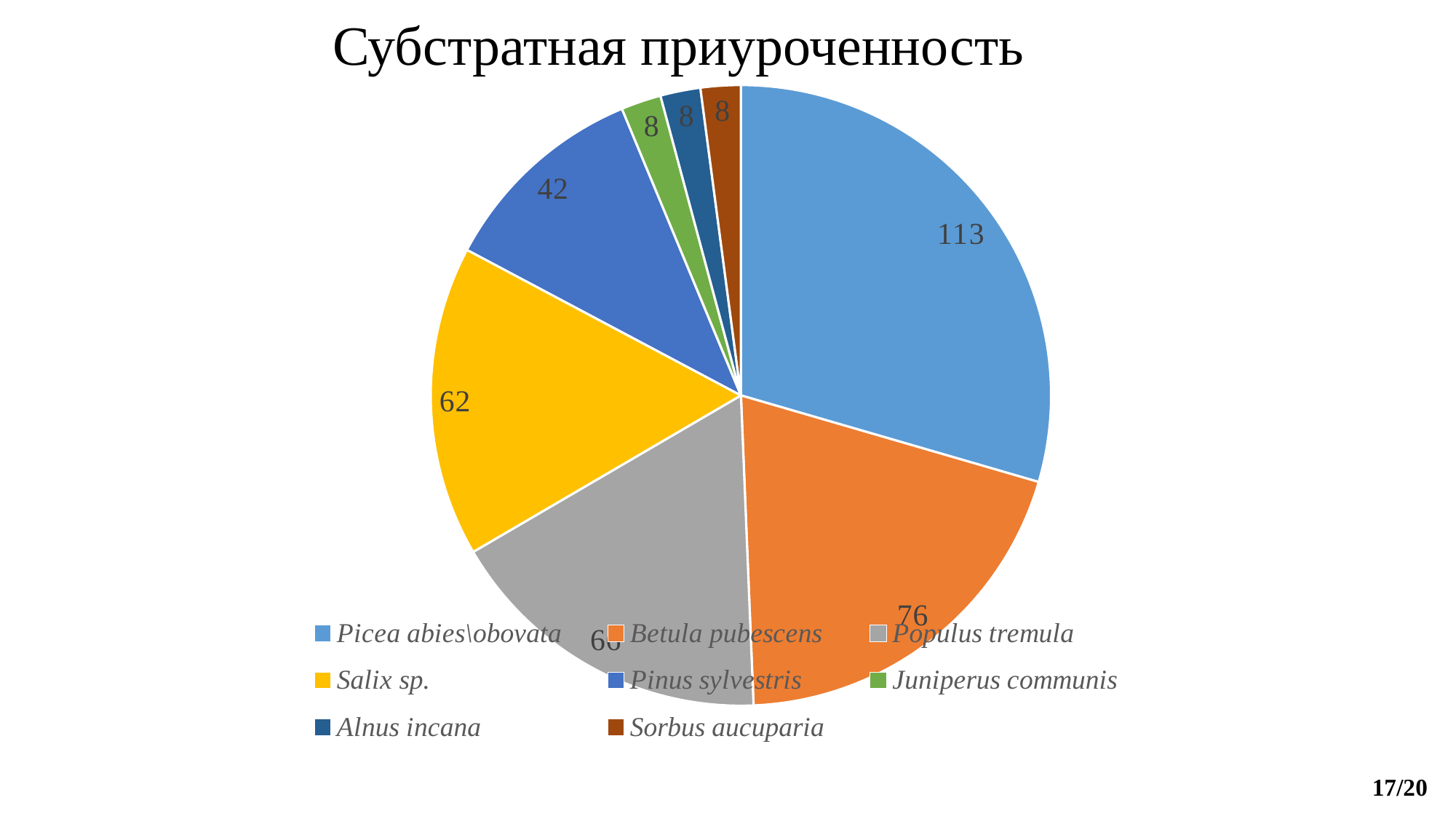
What kind of chart is shown on the slide? pie chart How many categories does the pie chart show? 8 What is the value for Salix sp.? 62 What is the value for Picea abies\obovata? 113 What is the difference between the values for Salix sp. and Pinus sylvestris? 20 What is the difference between the values for Picea abies\obovata and Betula pubescens? 37 What is the title of the chart? Субстратная приуроченность What is the value for Betula pubescens? 76 Which is larger, the value for Betula pubescens or the value for Salix sp.? Betula pubescens What is the value for Pinus sylvestris? 42 Which category has the largest slice of the pie? Picea abies\obovata What is the value for Juniperus communis? 8